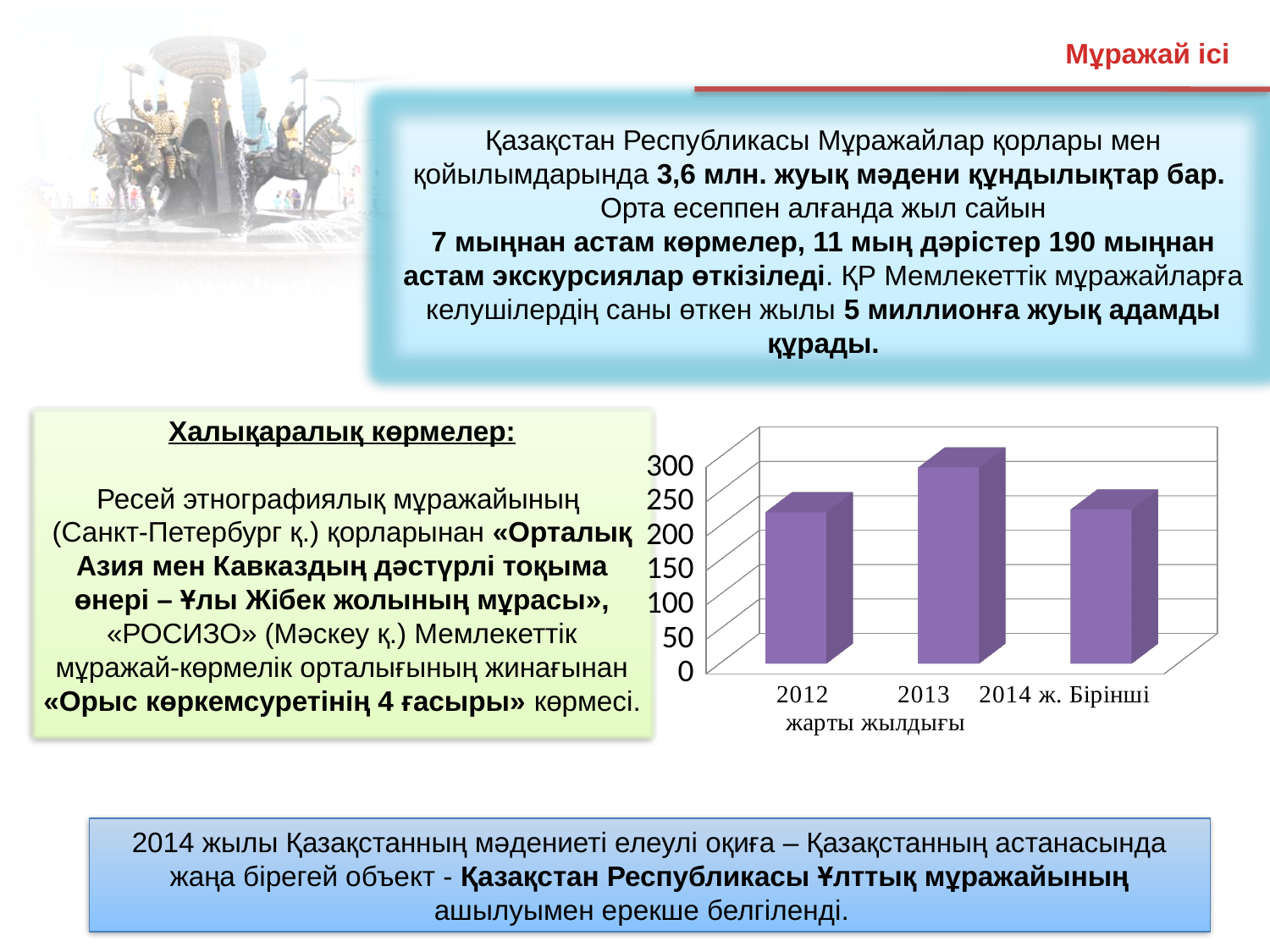
Does the value rise or fall from 2012 to 2013? rise Is the value for 2013 greater or less than 250? greater Which is larger, the value for 2013 or the value for 2012? 2013 Is the value for 2014 ж. Бірінші жарты жылдығы greater or less than 150? greater Is the value for 2012 greater or less than 200? greater How many categories are plotted on the bar chart? 3 What is the highest tick value shown on the vertical axis of the chart? 300 What colour are the bars in the chart? purple Which category has the highest bar on the chart? 2013 What kind of chart is shown on the slide? bar chart